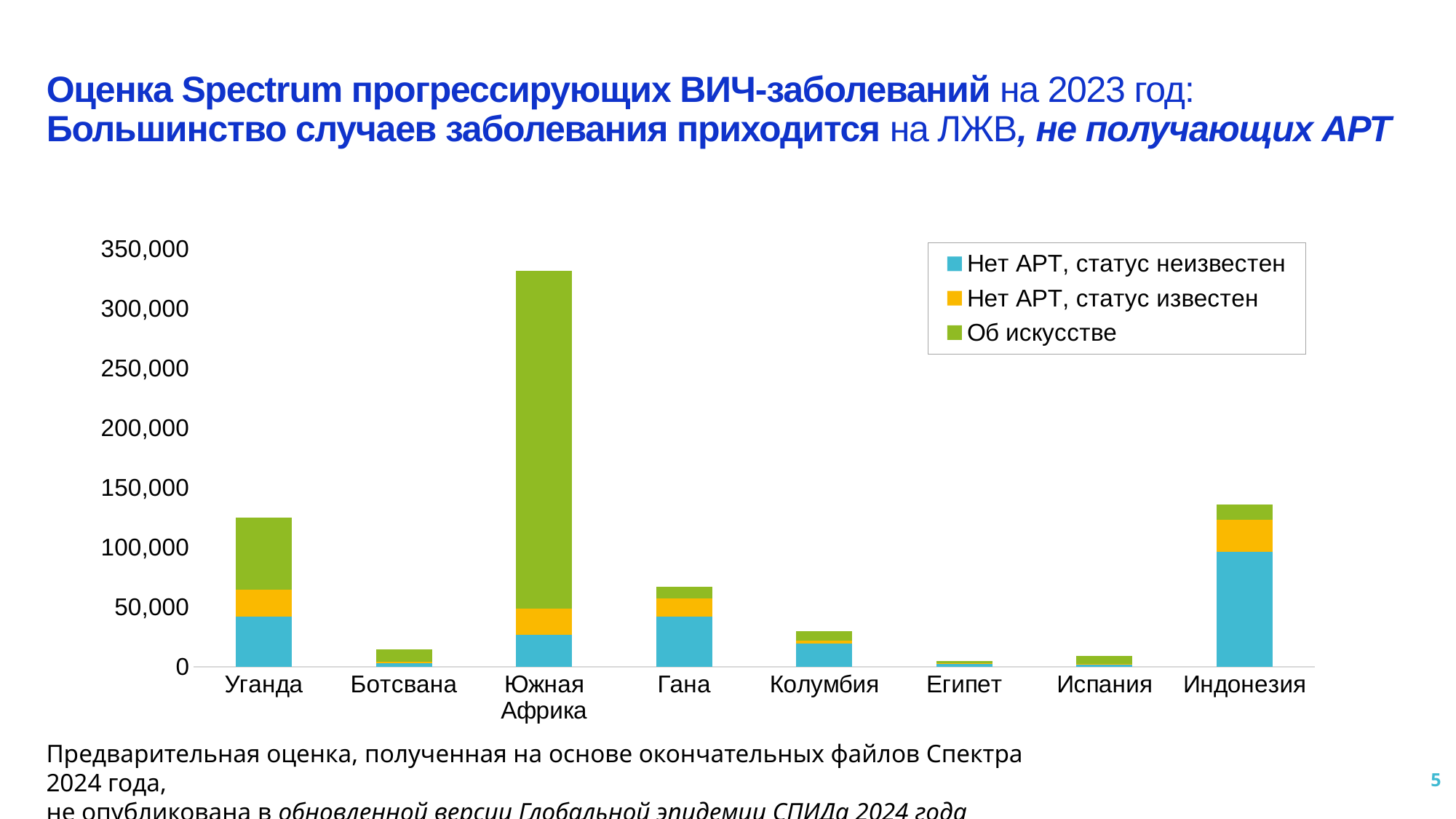
How many series does the chart legend list? 3 What kind of chart is shown on the slide? Stacked bar chart How many countries are shown on the x axis of the chart? 8 Which country has the highest total bar in the chart? Южная Африка Which series is shown in green in the chart legend? Об искусстве Is the total value for Индонезия greater or less than 100,000? greater Is the total value for Гана greater or less than 100,000? less Which series is shown in blue in the chart legend? Нет АРТ, статус неизвестен Is the total value for Южная Африка greater or less than 300,000? greater Which has the larger total bar, Уганда or Гана? Уганда